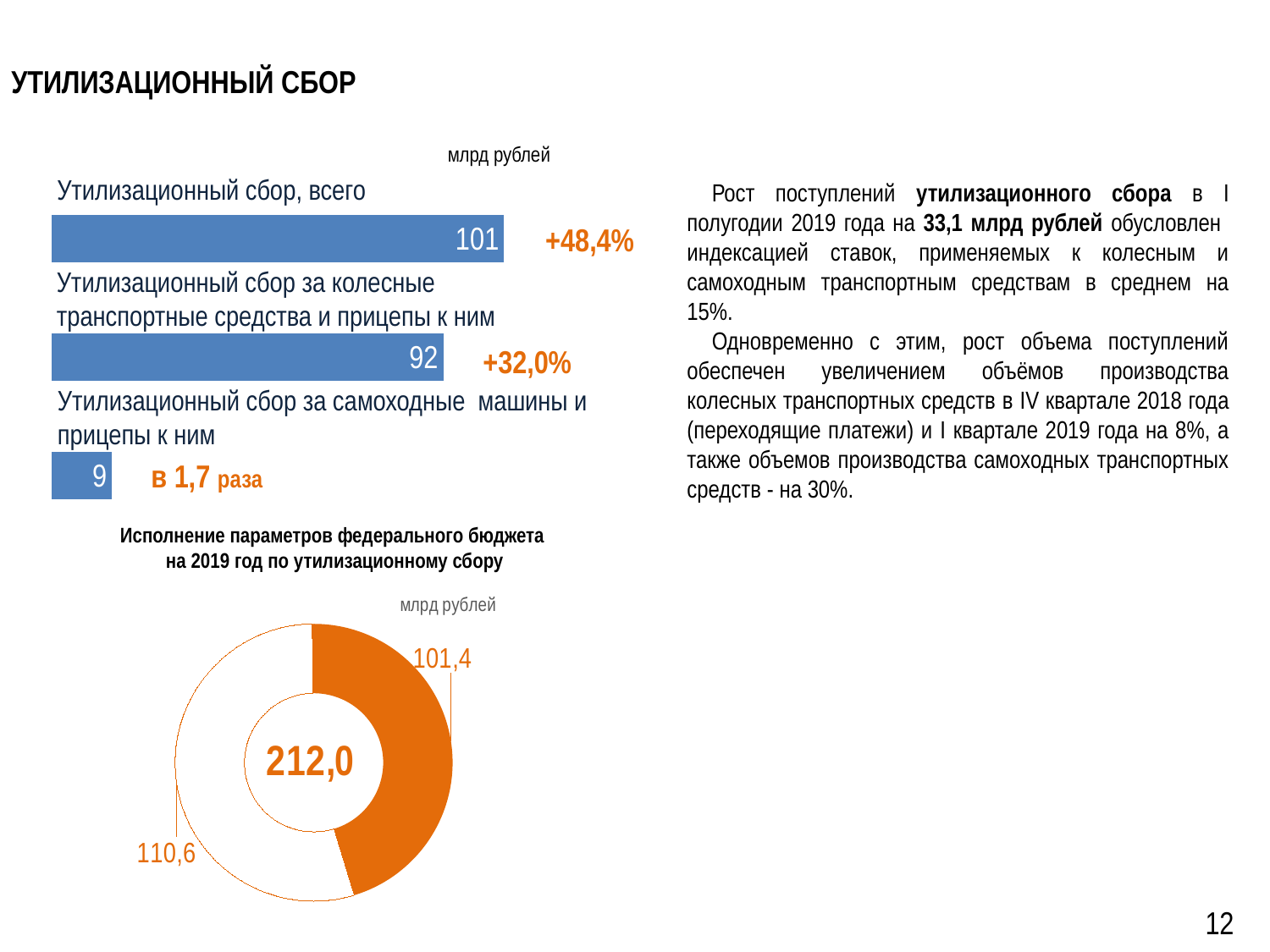
In the top bar chart, what growth percentage is shown next to the bar for 'Утилизационный сбор, всего'? +48,4% In the top bar chart, which category has the highest value? Утилизационный сбор, всего In the top bar chart, which category has the lowest value? Утилизационный сбор за самоходные машины и прицепы к ним In the top bar chart, what is the value for 'Утилизационный сбор, всего'? 101 In the donut chart 'Исполнение параметров федерального бюджета на 2019 год по утилизационному сбору', what total value is shown in the centre? 212,0 In the donut chart 'Исполнение параметров федерального бюджета на 2019 год по утилизационному сбору', which segment is larger: the one labelled 101,4 or the one labelled 110,6? 110,6 What type of chart is the chart titled 'Исполнение параметров федерального бюджета на 2019 год по утилизационному сбору'? Donut (pie) chart In the top bar chart, what is the difference between the value for 'Утилизационный сбор, всего' and the value for 'Утилизационный сбор за колесные транспортные средства и прицепы к ним'? 9 In the top bar chart, what is the value for 'Утилизационный сбор за самоходные машины и прицепы к ним'? 9 How many bars are in the top bar chart? 3 In the top bar chart, what is the value for 'Утилизационный сбор за колесные транспортные средства и прицепы к ним'? 92 In the donut chart 'Исполнение параметров федерального бюджета на 2019 год по утилизационному сбору', what value is shown for the orange segment? 101,4